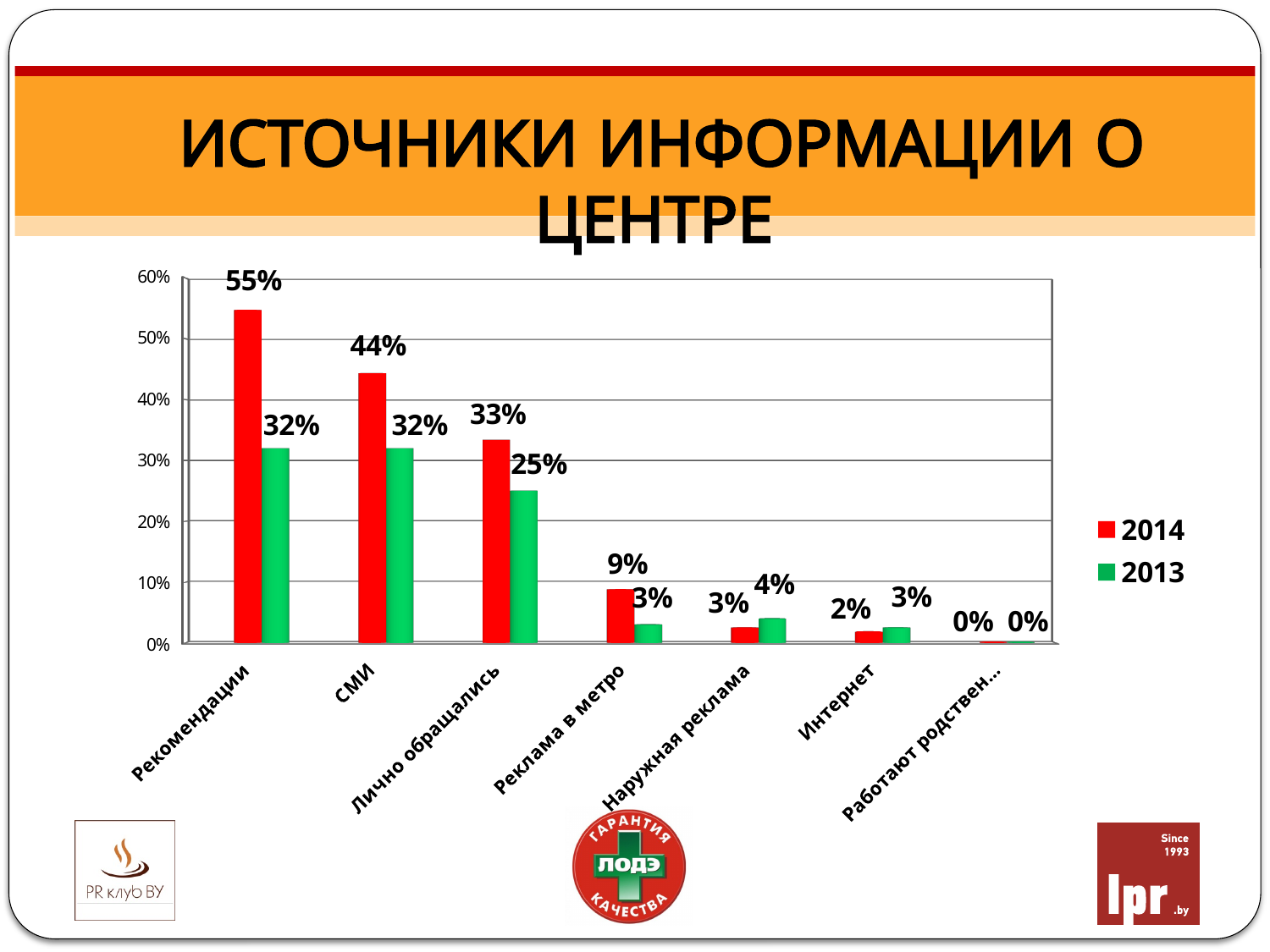
What is the value for Лично обращались in the 2013 series? 25% Which is larger for Наружная реклама, the 2014 value or the 2013 value? 2013 Which category has the highest value in the 2014 series? Рекомендации What is the difference between the 2014 and 2013 values for СМИ? 12% What kind of chart is shown on the slide? Bar chart What is the difference between the 2014 and 2013 values for Рекомендации? 23% Which is larger for Интернет, the 2014 value or the 2013 value? 2013 What is the value for Рекомендации in the 2014 series? 55% What is the value for Реклама в метро in the 2014 series? 9% What is the title of the slide containing the chart? ИСТОЧНИКИ ИНФОРМАЦИИ О ЦЕНТРЕ What is the value for СМИ in the 2013 series? 32% How many series does the legend list? 2